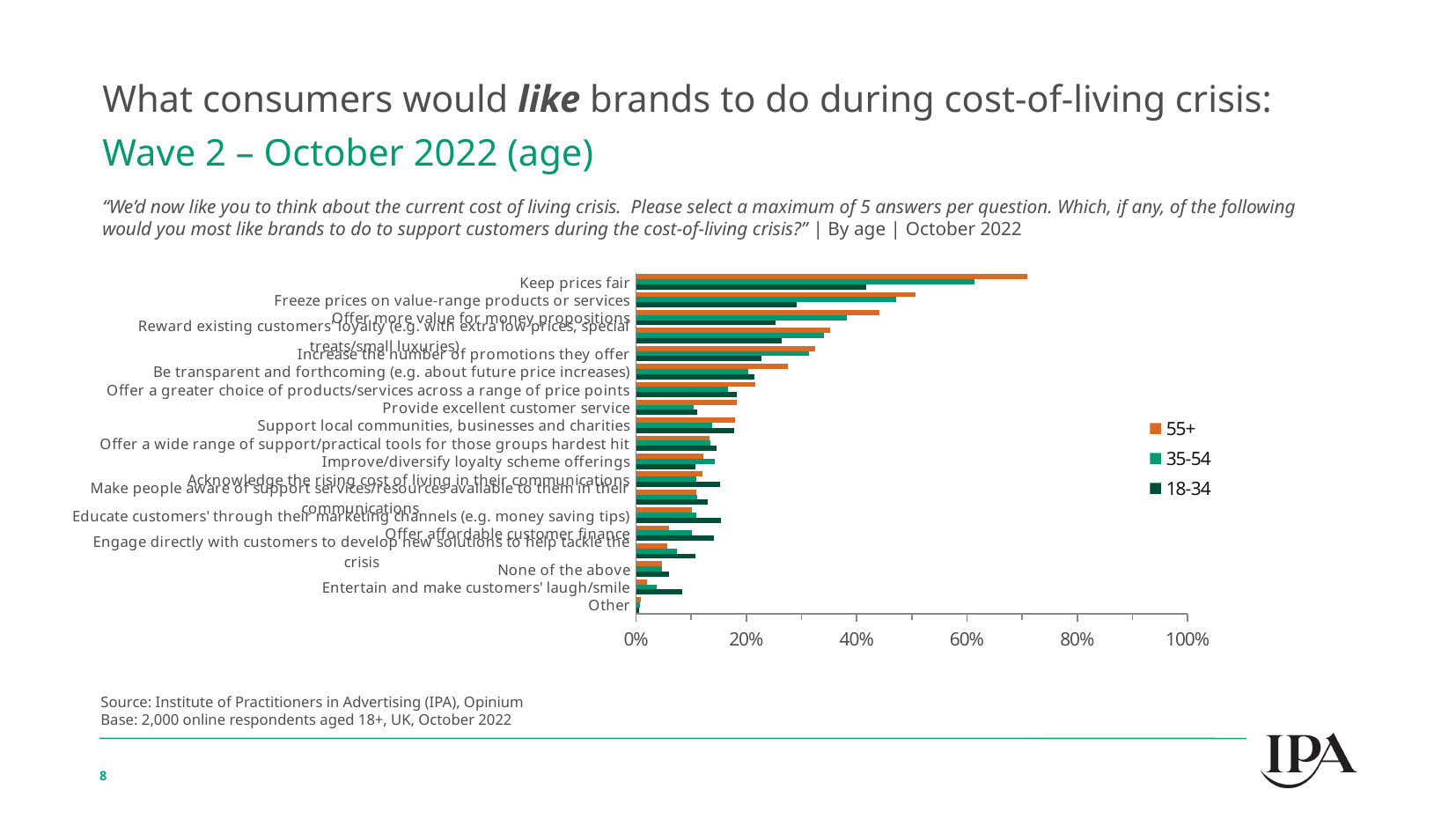
Which category has the highest value for the 55+ age group? Keep prices fair Is the value for 'Keep prices fair' among the 55+ age group greater or less than 60%? greater Is the value for 'Other' among the 55+ age group greater or less than 20%? less Which colour represents the 55+ age group in the chart? orange Which category has the highest value for the 18-34 age group? Keep prices fair For 'Entertain and make customers' laugh/smile', which age group has the larger value: 18-34 or 55+? 18-34 What kind of chart is shown on the slide? bar chart For 'Keep prices fair', which age group has the larger value: 55+ or 18-34? 55+ Which age groups are listed in the legend? 55+, 35-54, 18-34 How many series does the legend list? 3 Which category has the lowest value for the 55+ age group? Other Is the value for 'Freeze prices on value-range products or services' among the 55+ age group greater or less than 40%? greater